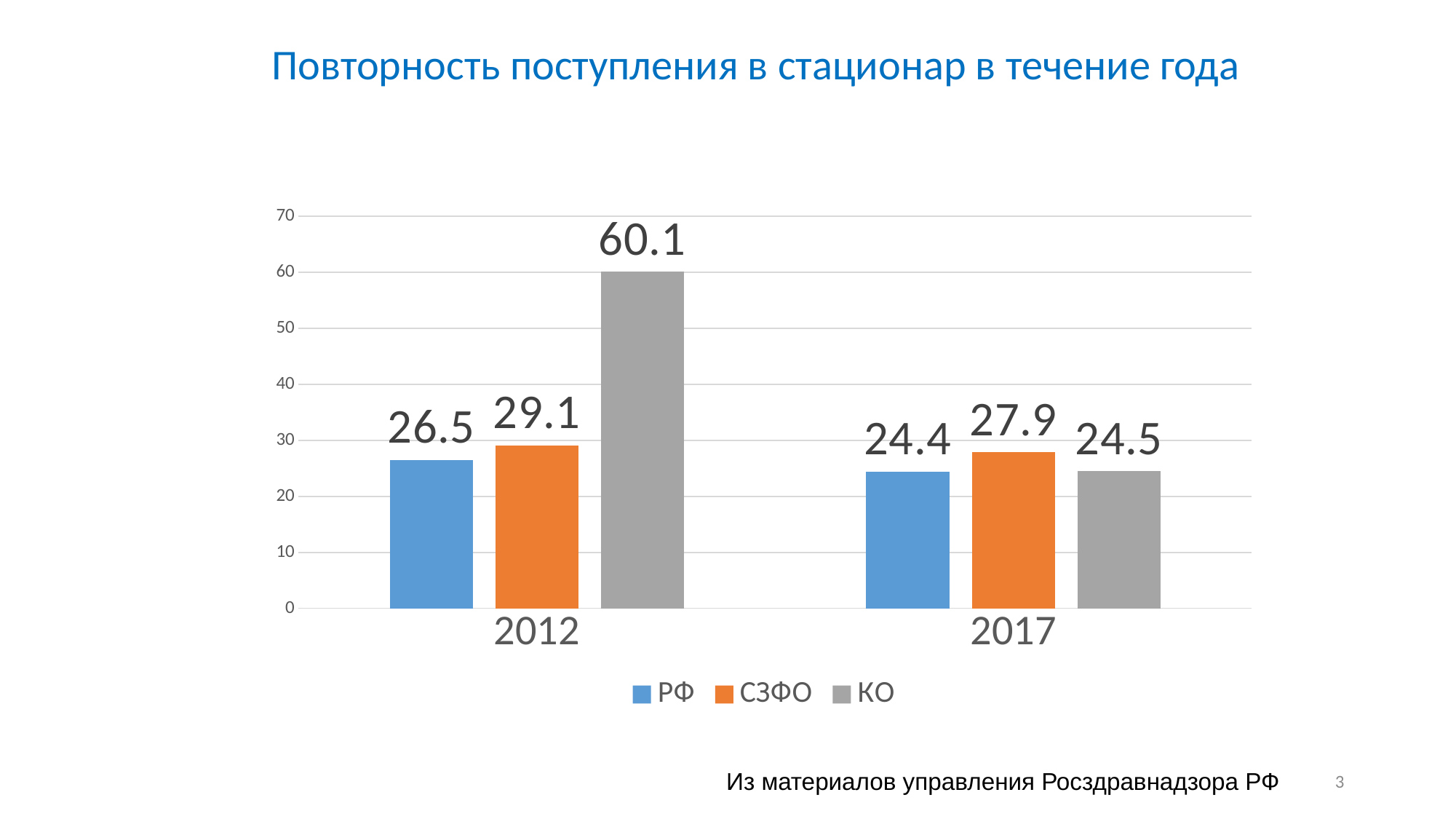
Which is larger, СЗФО in 2012 or СЗФО in 2017? СЗФО in 2012 What is the difference between the КО values for 2012 and 2017? 35.6 What is the value for РФ in 2017? 24.4 Which series has the lowest value in 2017? РФ How many year categories are shown on the x axis? 2 What is the difference between СЗФО and РФ in 2017? 3.5 Which series has the highest value in 2012? КО How many series does the legend list? 3 Does the value for РФ rise or fall from 2012 to 2017? Fall What kind of chart is shown on the slide? Bar chart What is the value for СЗФО in 2012? 29.1 What is the value for КО in 2012? 60.1